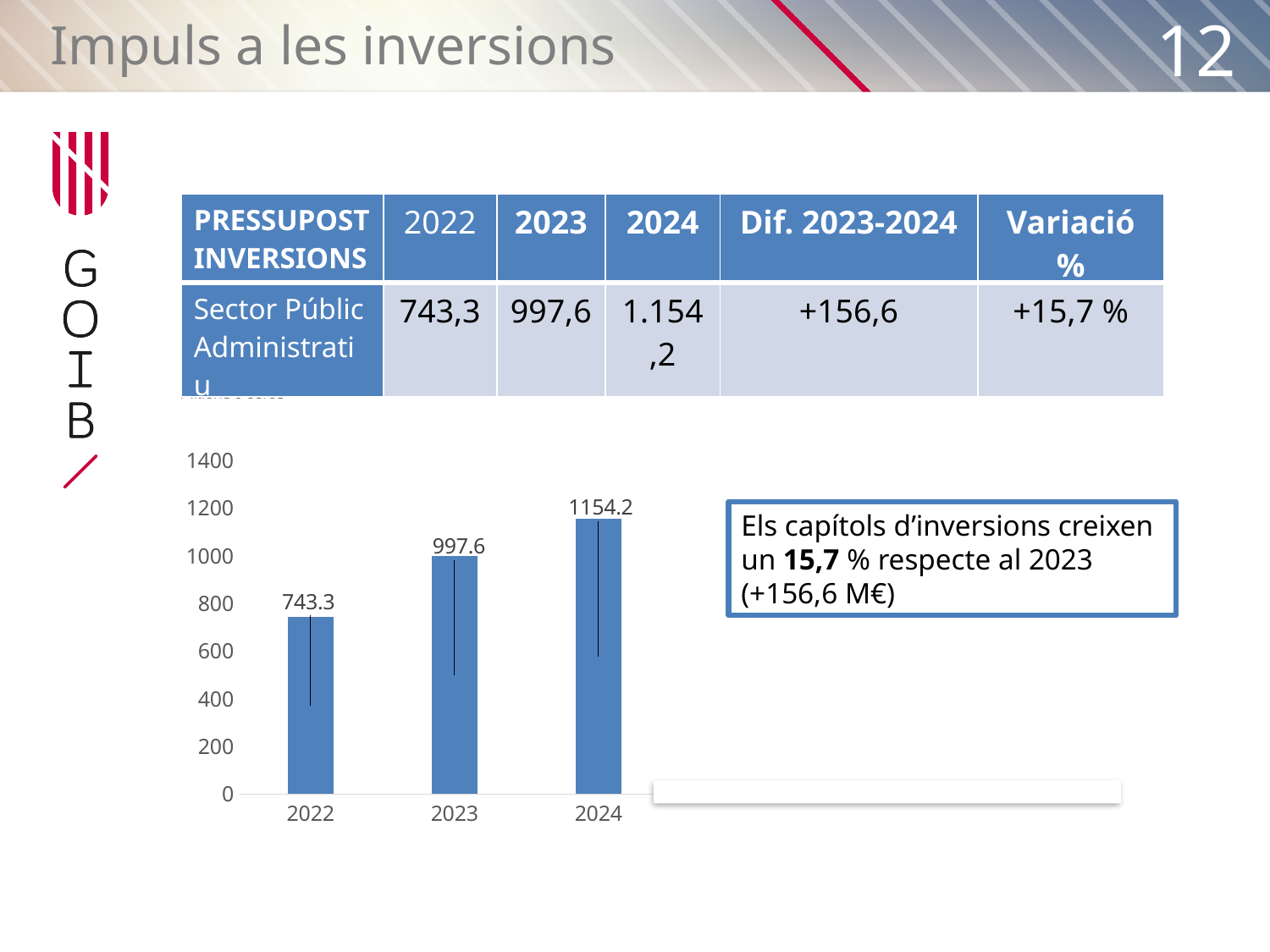
Which year has the highest bar in the chart? 2024 How many bars are plotted in the chart? 3 Is the value for 2024 in the bar chart greater or less than 1000? greater Do the values in the bar chart rise or fall from 2022 to 2024? rise What is the difference between the 2023 and 2022 values in the bar chart? 254.3 What is the value shown for 2023 in the bar chart? 997.6 Which year has the lowest bar in the chart? 2022 Which is larger in the bar chart, the value for 2022 or the value for 2023? 2023 What is the value shown for 2022 in the bar chart? 743.3 What kind of chart is shown on the slide? bar chart What is the difference between the 2024 and 2023 values in the bar chart? 156.6 What is the value shown for 2024 in the bar chart? 1154.2